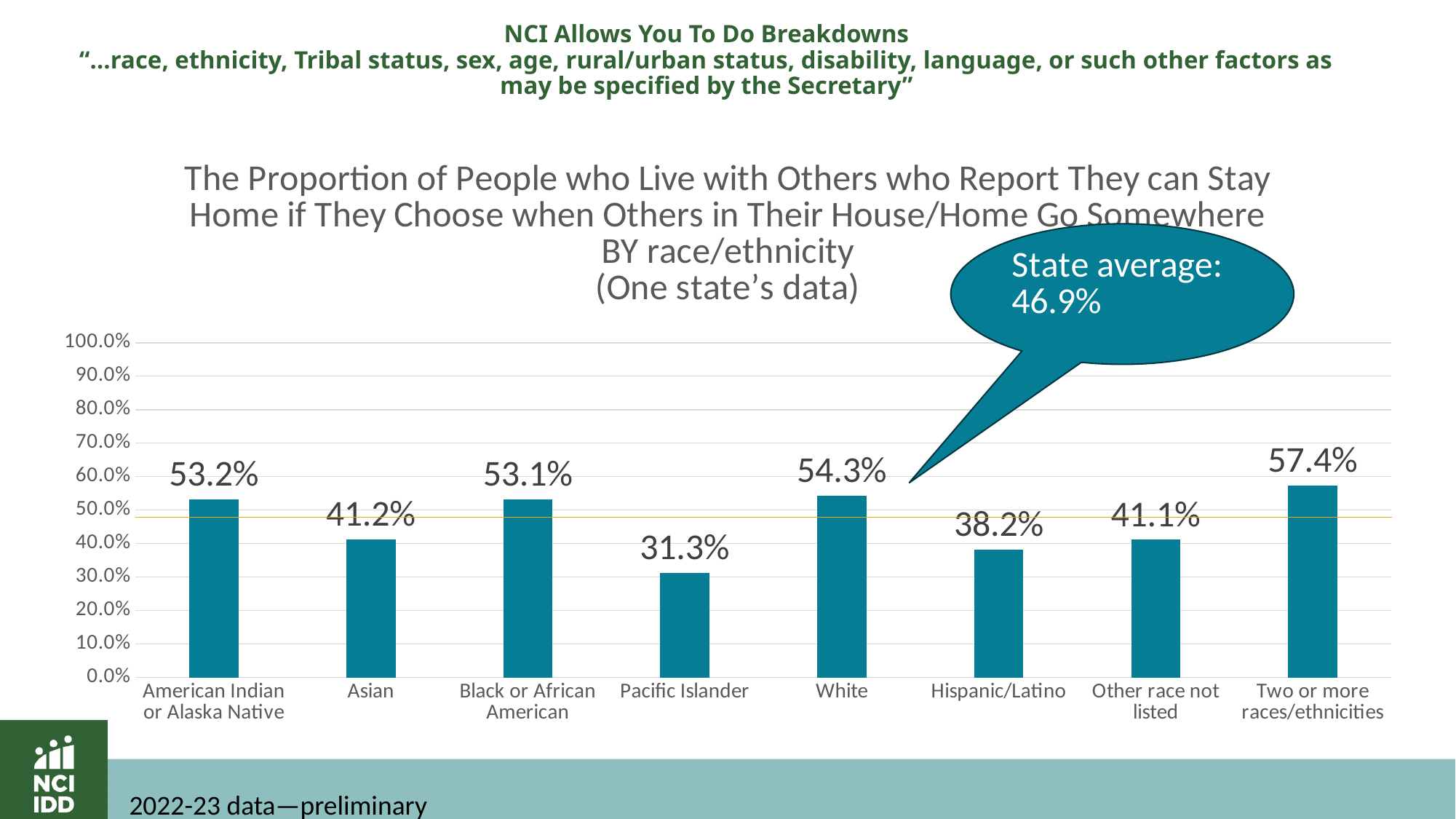
Which category has the highest value? Two or more races/ethnicities Which category has the lowest value? Pacific Islander What is the difference between the values for Two or more races/ethnicities and Pacific Islander? 26.1% What is the difference between the values for American Indian or Alaska Native and Black or African American? 0.1% What kind of chart is shown on the slide? bar chart What state average is given in the callout on the chart? 46.9% What is the value for Hispanic/Latino? 38.2% How many race/ethnicity categories are shown on the chart? 8 What is the value for Pacific Islander? 31.3% What is the value for White? 54.3% Which is larger, the value for Asian or the value for Hispanic/Latino? Asian Is the value for Other race not listed greater or less than 50.0%? less